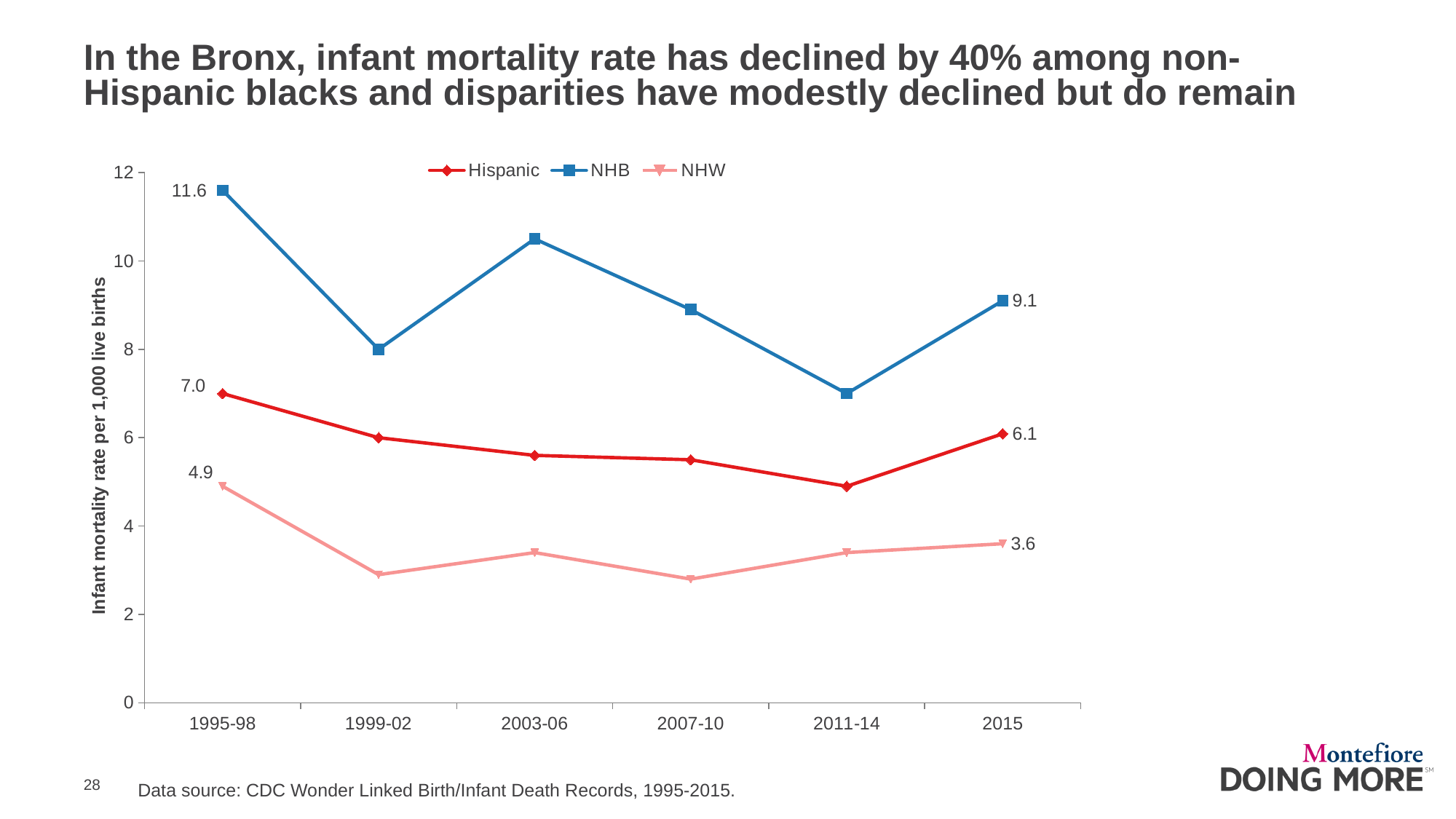
How many series does the legend list? 3 How many time periods are shown on the x axis? 6 Is the NHB value for 2003-06 greater or less than 10? greater What type of chart is shown on the slide? line chart Which is larger in 1995-98, the Hispanic rate or the NHW rate? Hispanic What is the infant mortality rate for NHB in 1995-98? 11.6 What is the difference between the NHB and NHW infant mortality rates in 2015? 5.5 What is the infant mortality rate for NHW in 2015? 3.6 Which series has the highest infant mortality rate in 2015? NHB By how much did the NHB infant mortality rate fall from 1995-98 to 2015? 2.5 What is the infant mortality rate for NHB in 2015? 9.1 What is the infant mortality rate for Hispanic in 1995-98? 7.0